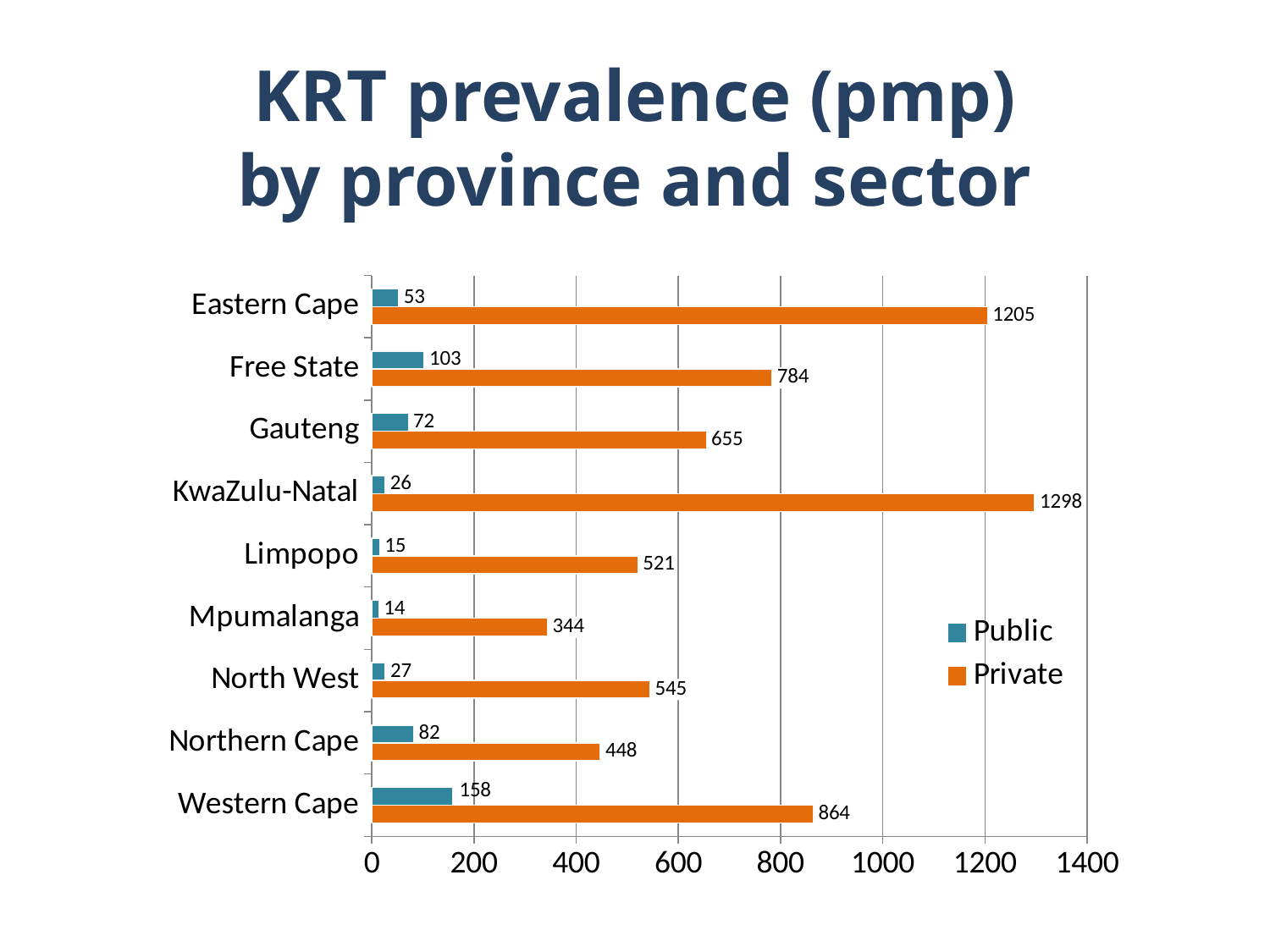
What is the Public KRT prevalence for Western Cape? 158 How many provinces are shown on the chart? 9 Which province has the highest Public KRT prevalence? Western Cape What is the Private KRT prevalence for KwaZulu-Natal? 1298 Which is larger, the Private value for Free State or the Private value for Western Cape? Western Cape Which colour represents the Private sector in the chart? Orange What is the Private value for Mpumalanga? 344 What is the difference between the Private and Public values for Eastern Cape? 1152 What kind of chart is shown on the slide? Bar chart Which province has the highest Private KRT prevalence? KwaZulu-Natal Which province has the lowest Public KRT prevalence? Mpumalanga How many series does the legend list? 2